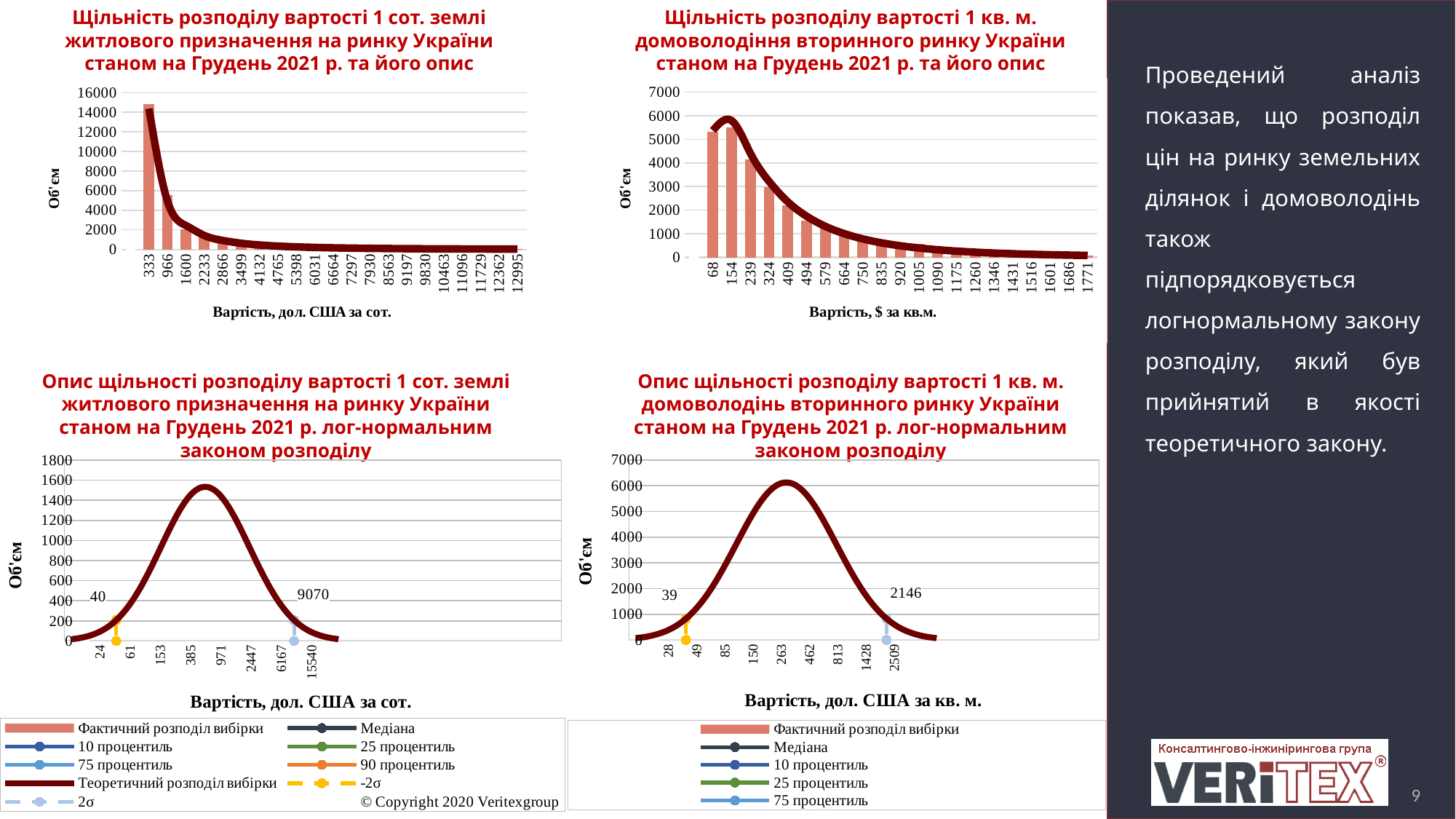
How many x-axis categories are shown in the top-right chart (1 кв. м. домоволодіння)? 21 What is the x-axis title of the bottom-left chart (лог-нормальний закон, 1 сот. землі)? Вартість, дол. США за сот. What kind of chart is the top-left chart titled "Щільність розподілу вартості 1 сот. землі житлового призначення..."? bar and line chart How many entries does the legend below the bottom-right chart list? 5 In the top-left chart (1 сот. землі), is the value for 333 greater or less than 12000? greater In the bottom-left chart (лог-нормальний закон, 1 сот. землі), what value is labeled at the right-hand marker on the curve? 9070 In the bottom-right chart (лог-нормальний закон, 1 кв. м.), what value is labeled at the left-hand marker on the curve? 39 In the top-left chart (1 сот. землі), is the value for 966 greater or less than 8000? less In the top-right chart (1 кв. м. домоволодіння), is the value for 1771 greater or less than 1000? less In the top-left chart (1 сот. землі), do the bar values rise or fall as you move along the x axis? fall In the top-left chart (1 сот. землі), which x-axis category has the highest bar? 333